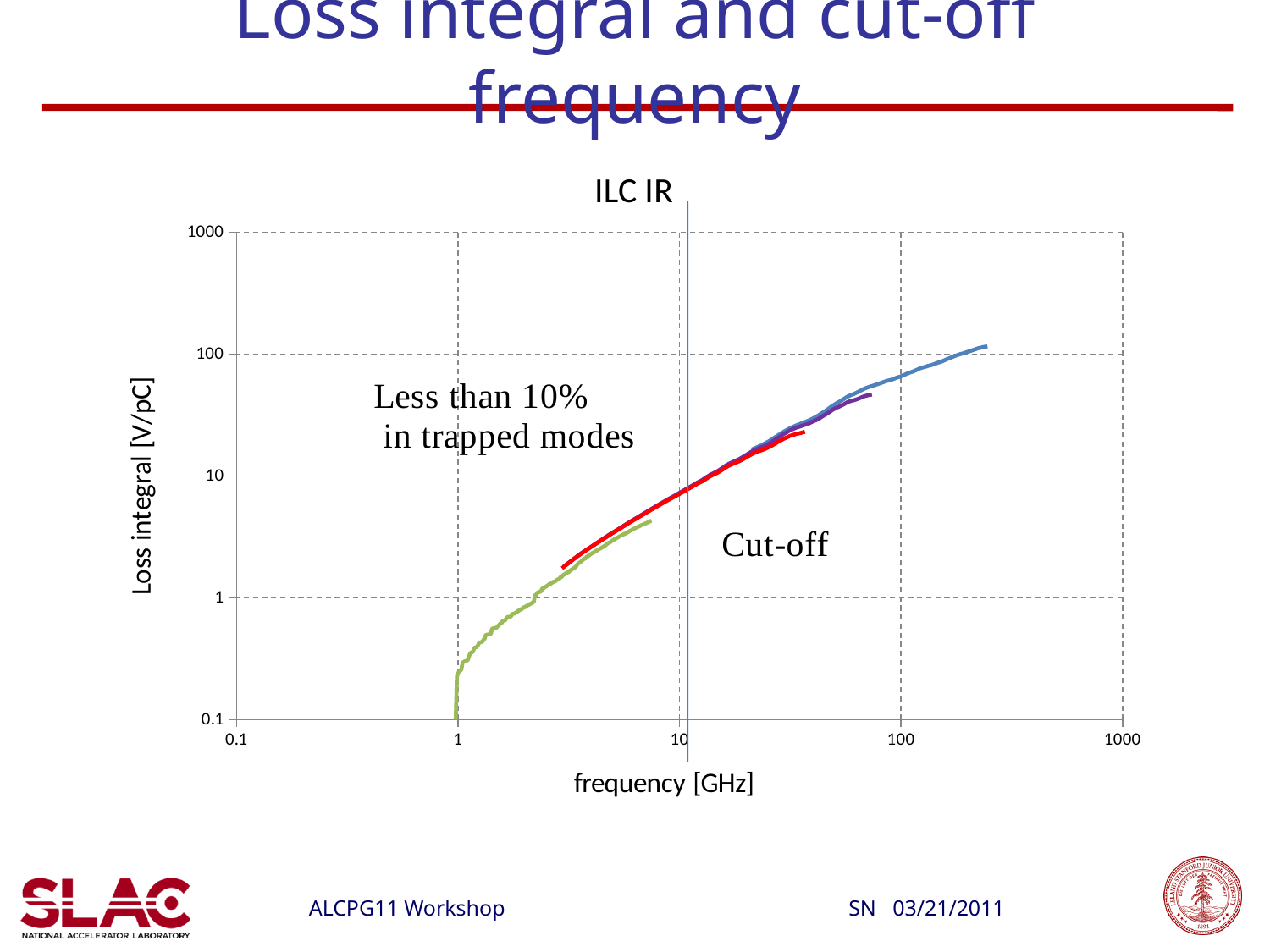
Is the cut-off frequency marked by the vertical line greater or less than 10 GHz? greater Is the highest value reached by the blue line greater or less than 100 V/pC? greater Is the loss integral of the green line at 5 GHz greater or less than 10 V/pC? less What kind of chart is shown on the slide? line chart Which line reaches the highest loss integral value on the chart, the green line or the blue line? blue line Does the loss integral rise or fall as frequency increases along the x axis? rise What is the label of the x axis of the chart? frequency [GHz] What is the title of the chart? ILC IR What is the highest tick value shown on the y axis of the chart? 1000